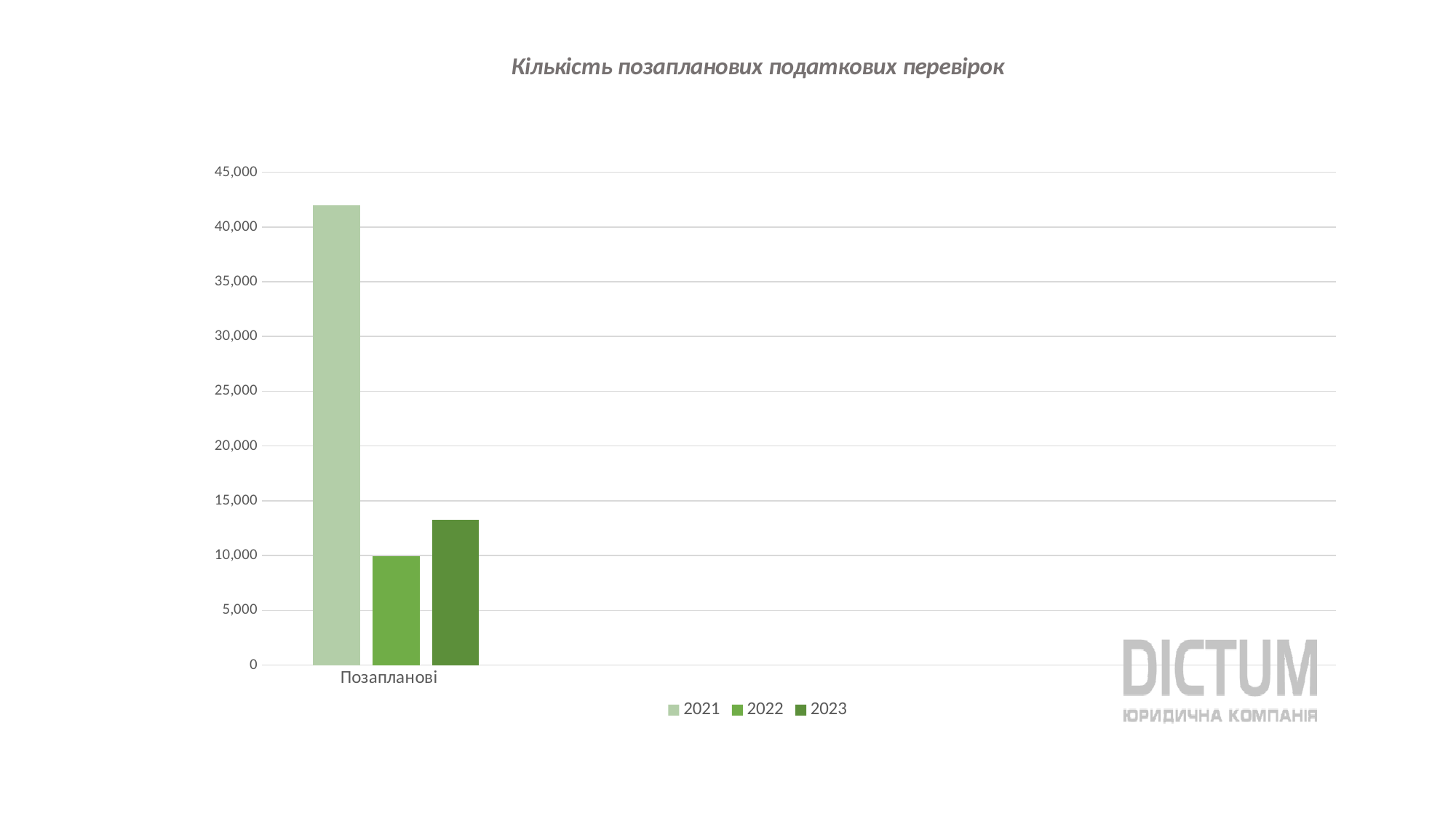
What kind of chart is shown on the slide? bar chart How many categories are shown on the x axis? 1 Which year has the highest value for Позапланові? 2021 Is the value for 2021 greater or less than 45,000? less Which year has the lowest value for Позапланові? 2022 Which years are listed in the legend? 2021, 2022, 2023 Is the value for 2022 greater or less than 15,000? less What is the title of the chart? Кількість позапланових податкових перевірок Is the value for 2021 greater or less than 40,000? greater How many series does the legend list? 3 Which is larger for Позапланові, the value for 2022 or the value for 2023? 2023